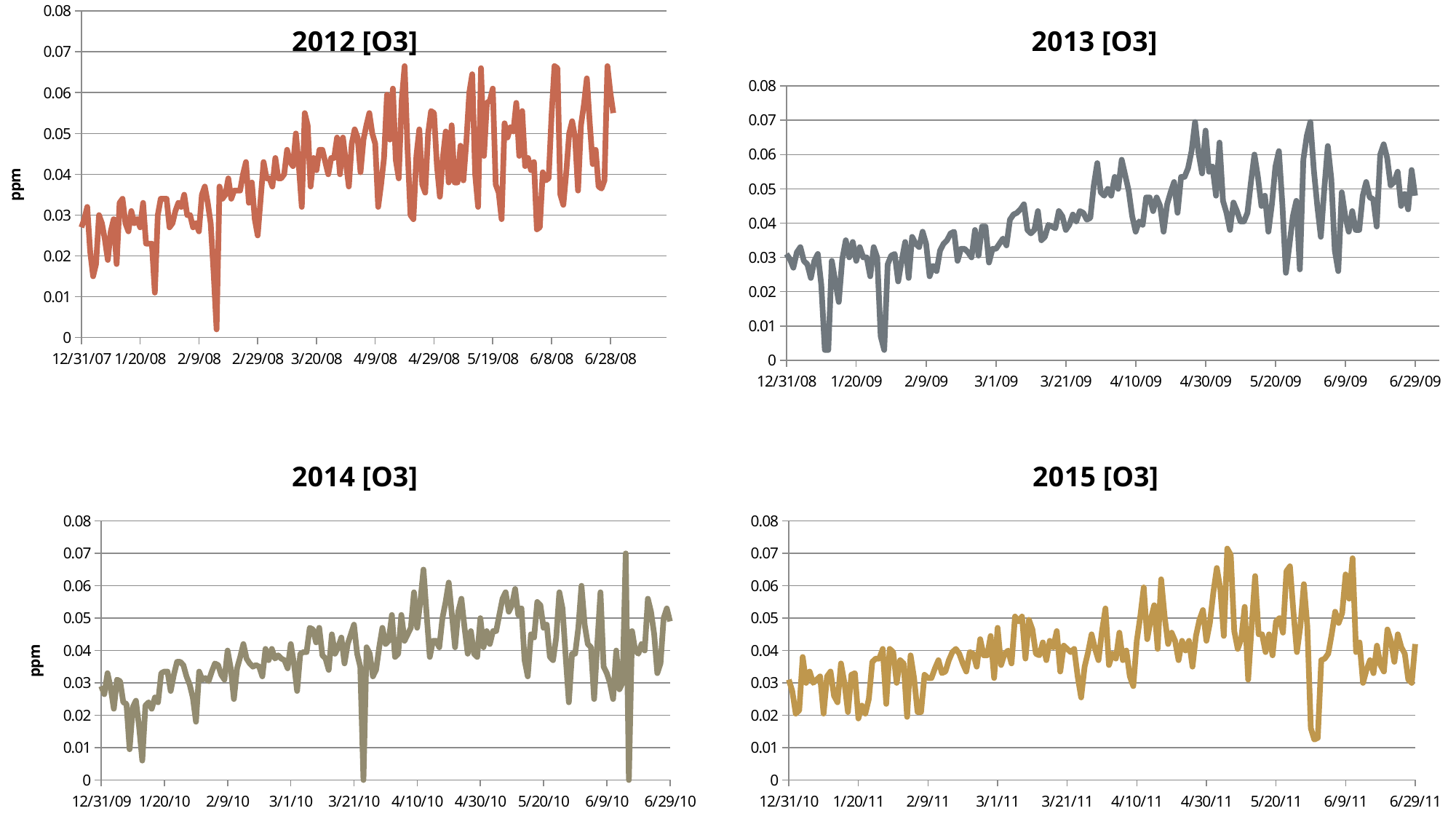
In the 2012 [O3] chart, is the value at 12/31/07 greater or less than 0.04? less What is the title of the chart in the top-right of the slide? 2013 [O3] In the 2014 [O3] chart, is the value at 12/31/09 greater or less than 0.04? less In the 2013 [O3] chart, is the value at 6/29/09 larger or smaller than the value at 12/31/08? larger What kind of chart is the 2012 [O3] chart? line chart In the 2015 [O3] chart, do the values generally rise or fall between 12/31/10 and 4/10/11? rise In the 2012 [O3] chart, is the lowest value plotted greater or less than 0.01? less What is the label on the vertical axis of the 2014 [O3] chart? ppm In the 2013 [O3] chart, do the values generally rise or fall from 12/31/08 to 6/29/09? rise How many charts are shown on the slide? 4